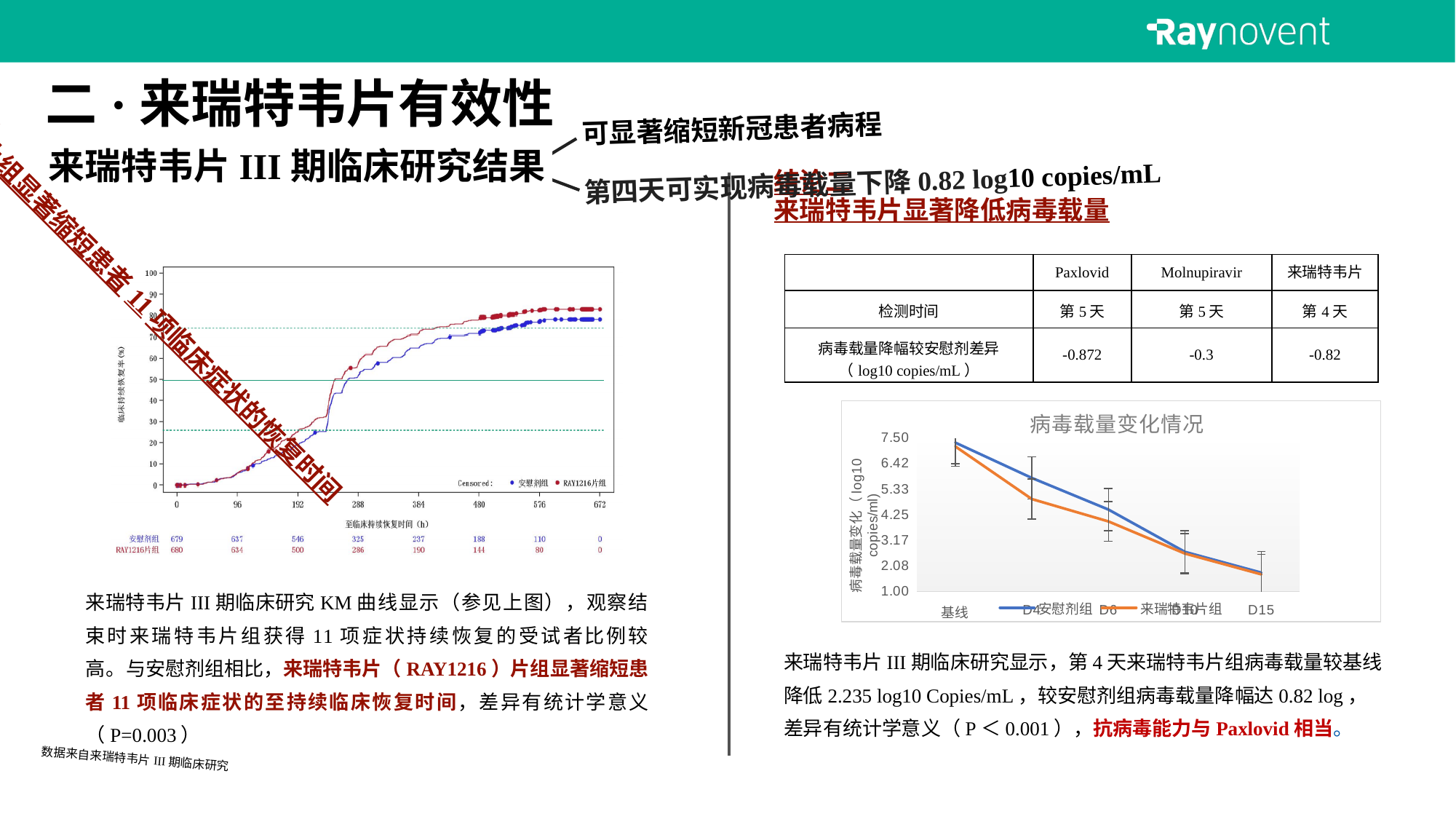
In the 病毒载量变化情况 chart, do the values rise or fall from 基线 to D15? fall In the 病毒载量变化情况 chart, is the value for 安慰剂组 at 基线 greater or less than 6.42? greater What is the title of the line chart on the right of the slide? 病毒载量变化情况 In the KM curve chart on the left, do the curves rise or fall as time increases along the x axis? rise In the KM curve chart on the left, what is the number at risk for 安慰剂组 at time 0? 679 How many time points are shown on the x axis of the 病毒载量变化情况 chart? 5 What kind of chart is the chart titled 病毒载量变化情况 on the right of the slide? line chart How many series does the legend of the 病毒载量变化情况 chart list? 2 In the 病毒载量变化情况 chart, is the value for 来瑞特韦片组 at D15 greater or less than 2.08? less In the 病毒载量变化情况 chart, which series has the larger value at D4, 安慰剂组 or 来瑞特韦片组? 安慰剂组 In the KM curve chart on the left, what is the number at risk for RAY1216片组 at 288 h? 286 In the KM curve chart on the left, which two groups does the legend list? 安慰剂组 and RAY1216片组